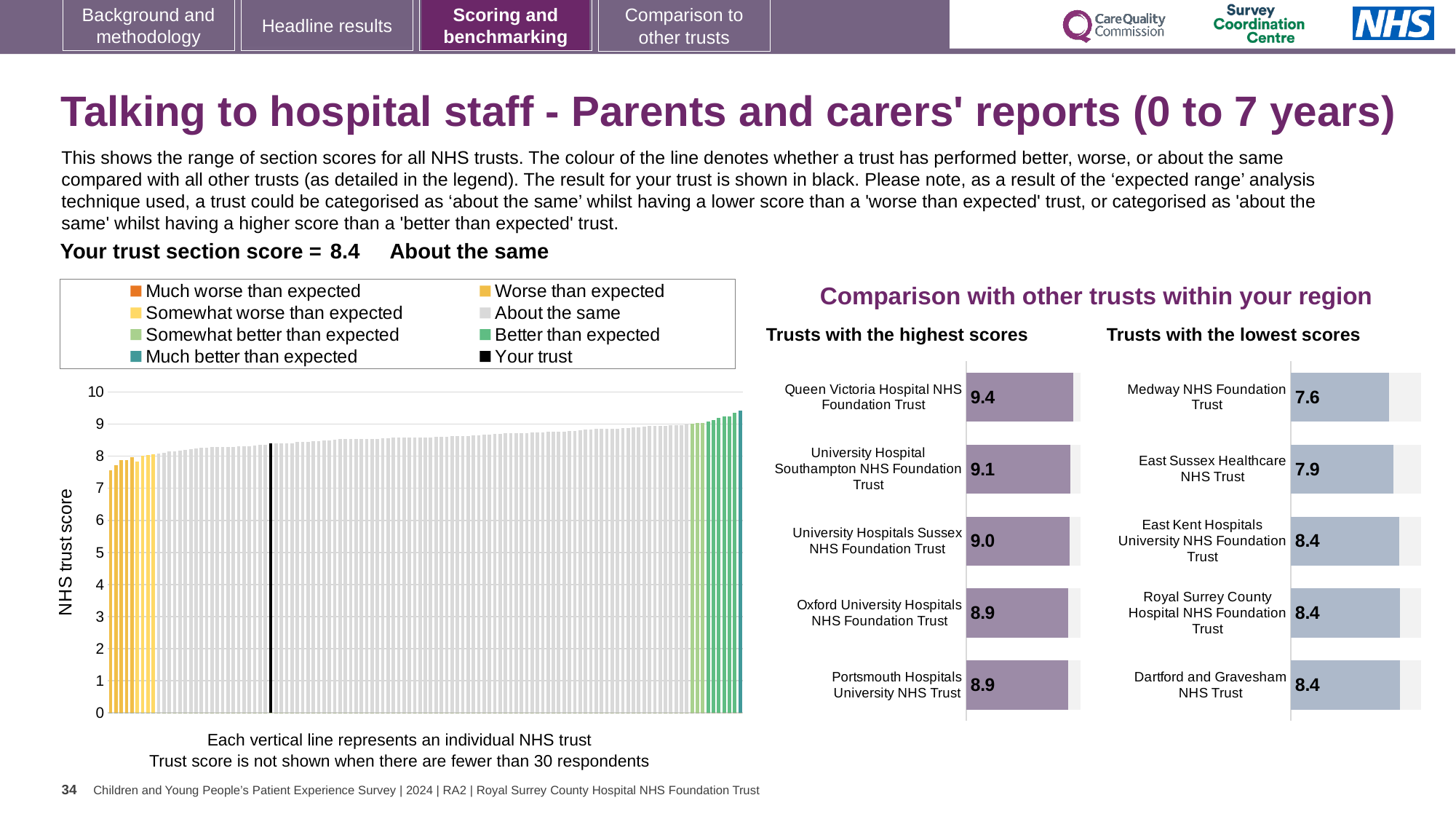
In the 'Trusts with the highest scores' chart, what is the score for Queen Victoria Hospital NHS Foundation Trust? 9.4 In the 'Trusts with the lowest scores' chart, what is the difference between the scores of East Sussex Healthcare NHS Trust and Medway NHS Foundation Trust? 0.3 In the 'NHS trust score' chart on the left, do the values rise or fall from left to right? rise In the 'Trusts with the highest scores' chart, which has the higher score: University Hospitals Sussex NHS Foundation Trust or Oxford University Hospitals NHS Foundation Trust? University Hospitals Sussex NHS Foundation Trust In the 'NHS trust score' chart on the left, is the value of the black 'Your trust' line greater or less than 5? greater In the 'Trusts with the highest scores' chart, what is the difference between the scores of Queen Victoria Hospital NHS Foundation Trust and University Hospital Southampton NHS Foundation Trust? 0.3 How many entries does the legend above the 'NHS trust score' chart list? 8 In the 'Trusts with the lowest scores' chart, which trust has the lowest score? Medway NHS Foundation Trust In the 'Trusts with the highest scores' chart, which trust has the highest score? Queen Victoria Hospital NHS Foundation Trust What kind of chart is the large 'NHS trust score' chart on the left of the slide? bar chart In the 'Trusts with the lowest scores' chart, what is the score for Medway NHS Foundation Trust? 7.6 How many trusts are shown in the 'Trusts with the highest scores' chart? 5